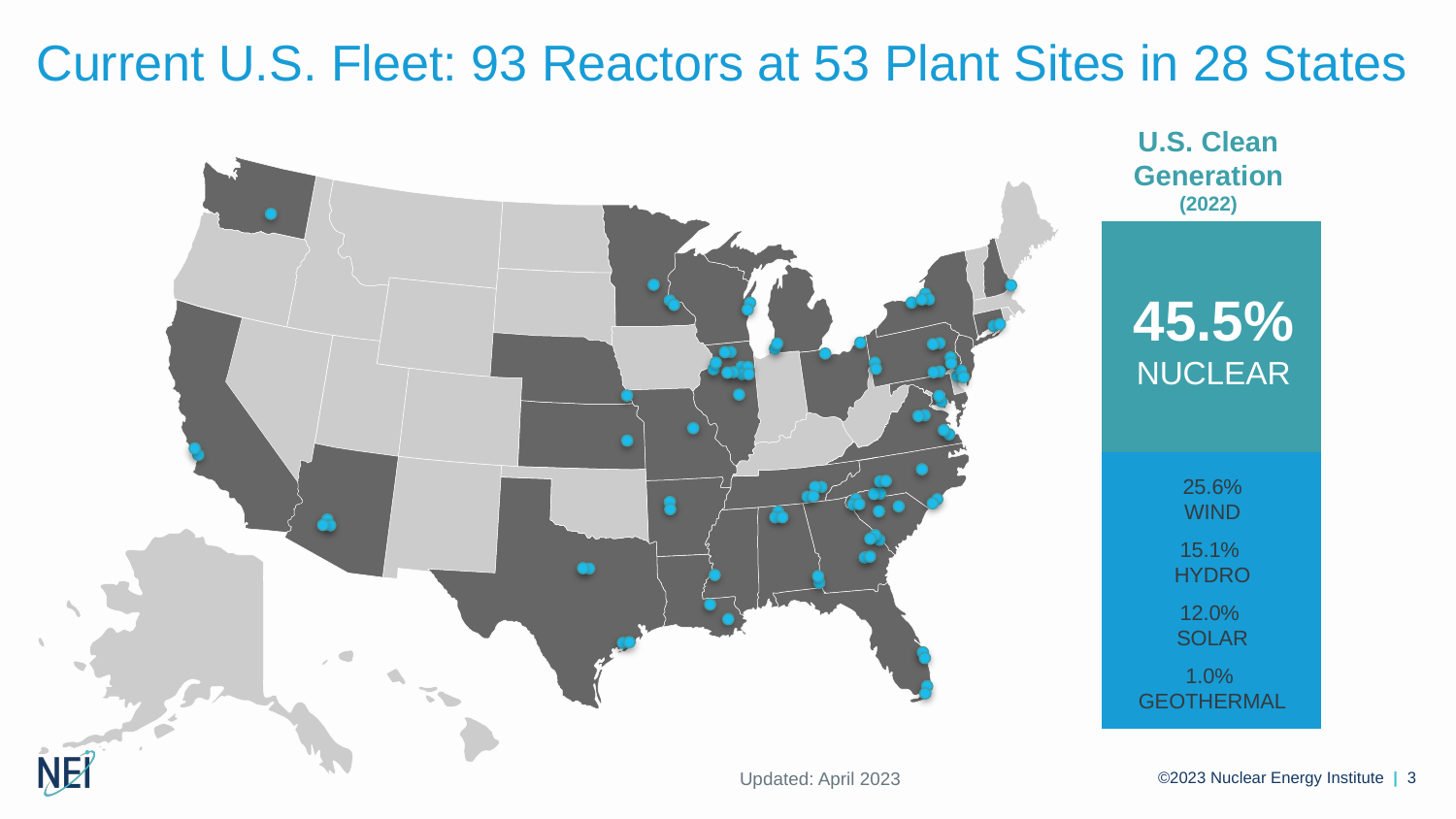
In the U.S. Clean Generation (2022) panel, what share is attributed to nuclear? 45.5% In the U.S. Clean Generation (2022) panel, which is larger, the hydro share or the solar share? Hydro According to the slide title, how many reactors are in the current U.S. fleet? 93 How many energy sources are listed in the U.S. Clean Generation (2022) panel? 5 According to the slide title, how many states have nuclear plant sites? 28 In the U.S. Clean Generation (2022) panel, what share is attributed to solar? 12.0% In the U.S. Clean Generation (2022) panel, how many percentage points larger is the nuclear share than the wind share? 19.9 percentage points In the U.S. Clean Generation (2022) panel, what share is attributed to wind? 25.6% In the U.S. Clean Generation (2022) panel, what share is attributed to hydro? 15.1% In the U.S. Clean Generation (2022) panel, which source has the smallest share? Geothermal In the U.S. Clean Generation (2022) panel, what share is attributed to geothermal? 1.0% In the U.S. Clean Generation (2022) panel, which source has the largest share? Nuclear